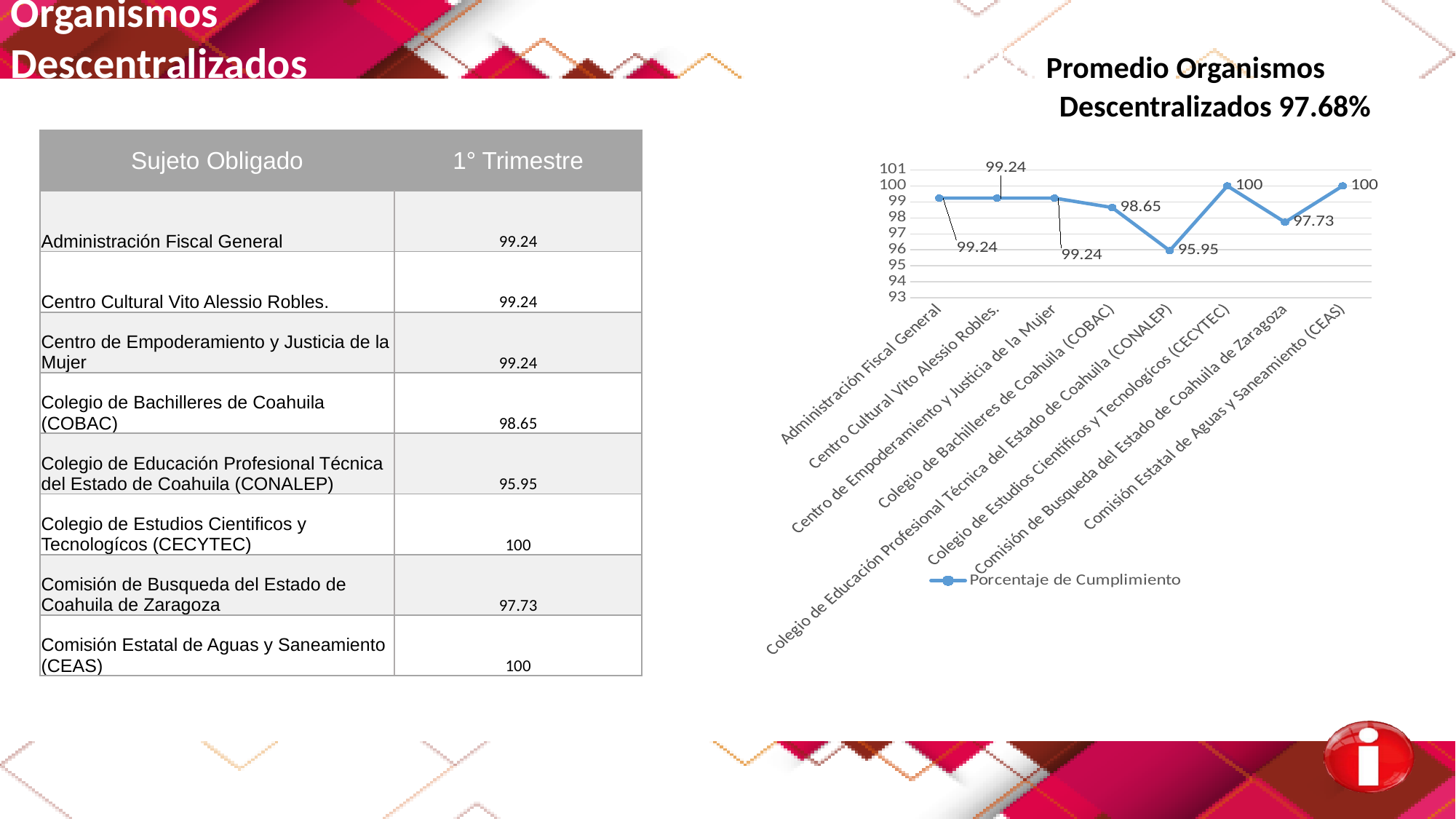
How many series does the legend list? 1 Is the value for Colegio de Educación Profesional Técnica del Estado de Coahuila (CONALEP) greater or less than 97? less Which category has the lowest value? Colegio de Educación Profesional Técnica del Estado de Coahuila (CONALEP) What is the value for Comisión de Busqueda del Estado de Coahuila de Zaragoza? 97.73 What is the value for Colegio de Educación Profesional Técnica del Estado de Coahuila (CONALEP)? 95.95 Which is larger, the value for Colegio de Bachilleres de Coahuila (COBAC) or the value for Comisión de Busqueda del Estado de Coahuila de Zaragoza? Colegio de Bachilleres de Coahuila (COBAC) What type of chart is shown on the slide? line chart What is the value for Administración Fiscal General? 99.24 What is the difference between the values for Colegio de Estudios Cientificos y Tecnologícos (CECYTEC) and Colegio de Educación Profesional Técnica del Estado de Coahuila (CONALEP)? 4.05 How many categories are plotted on the chart? 8 What is the name of the series shown in the legend? Porcentaje de Cumplimiento What is the value for Colegio de Bachilleres de Coahuila (COBAC)? 98.65